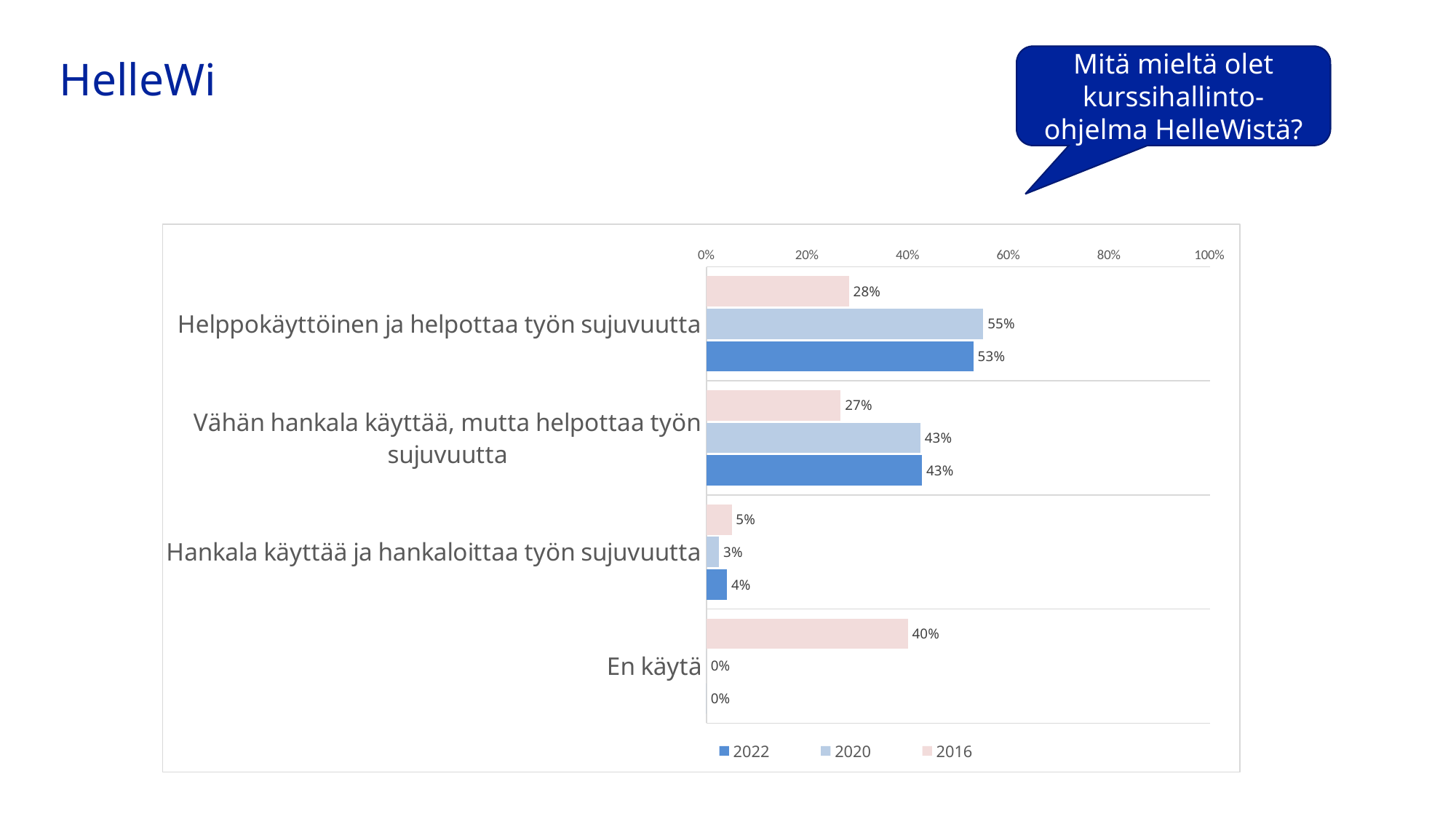
What kind of chart is shown on the slide? bar chart Which category has the highest 2020 value? Helppokäyttöinen ja helpottaa työn sujuvuutta What is the 2020 value for "Hankala käyttää ja hankaloittaa työn sujuvuutta"? 3% How many series does the legend list? 3 Is the 2016 value for "En käytä" greater or less than 20%? greater Which is larger for "Vähän hankala käyttää, mutta helpottaa työn sujuvuutta": the 2022 value or the 2016 value? 2022 What is the difference between the 2020 and 2016 values for "Helppokäyttöinen ja helpottaa työn sujuvuutta"? 27% Which series is shown in dark blue in the legend? 2022 What is the 2016 value for "En käytä"? 40% What is the 2022 value for "Helppokäyttöinen ja helpottaa työn sujuvuutta"? 53% How many categories are shown on the chart? 4 Which category has the lowest 2016 value? Hankala käyttää ja hankaloittaa työn sujuvuutta